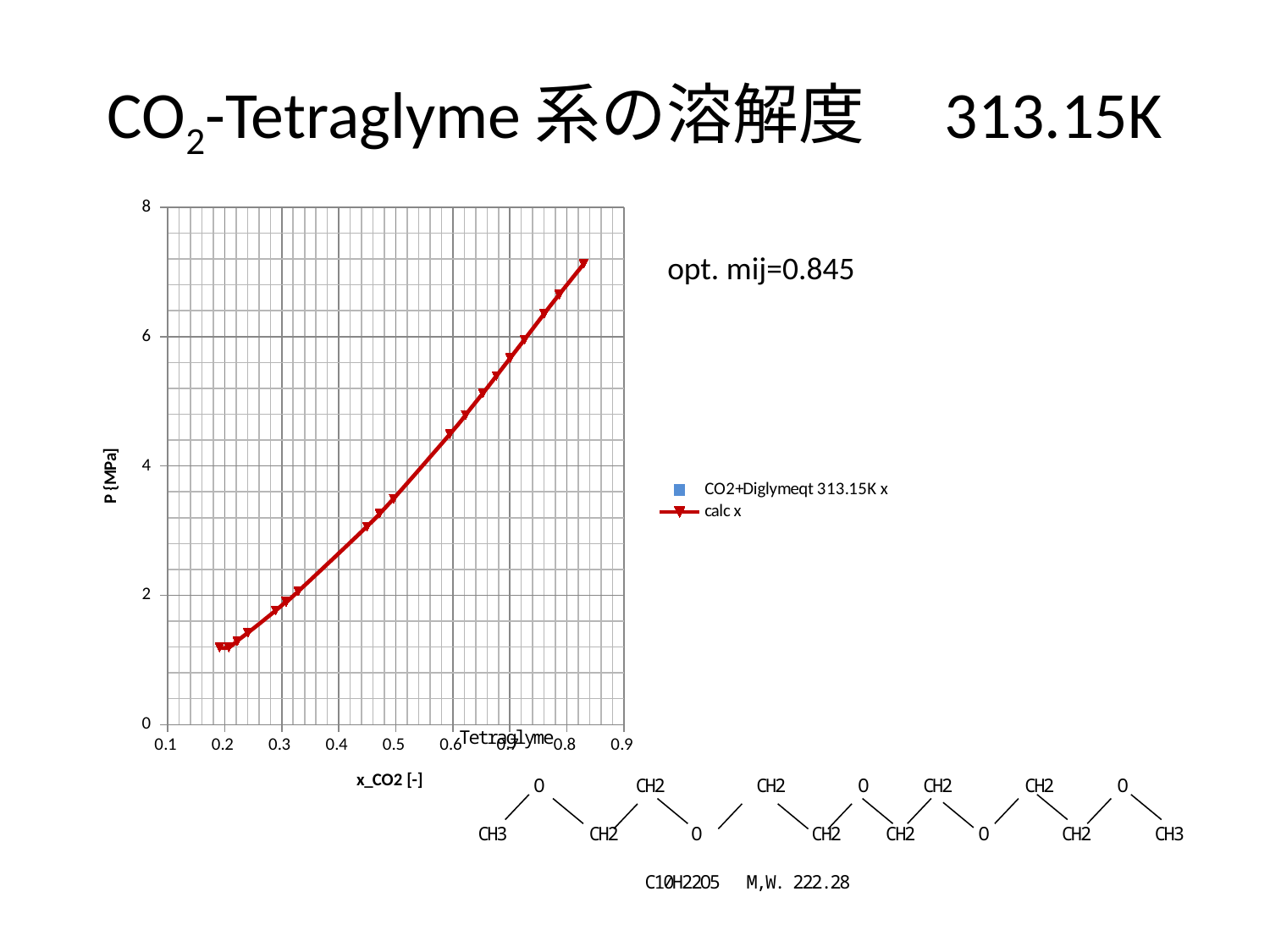
Is the value of P at x_CO2 = 0.5 greater or less than 4 MPa? less What are the two series names listed in the chart legend? CO2+Diglymeqt 313.15K x; calc x Does the pressure P rise or fall as x_CO2 increases along the x axis? rises What kind of chart is shown on the slide? line chart Is the value of P at x_CO2 = 0.3 greater or less than 2 MPa? less Is P larger at x_CO2 = 0.8 or at x_CO2 = 0.2? 0.8 Is the value of P at x_CO2 = 0.6 greater or less than 4 MPa? greater What is the label of the chart's y axis? P [MPa] How many series does the chart legend list? 2